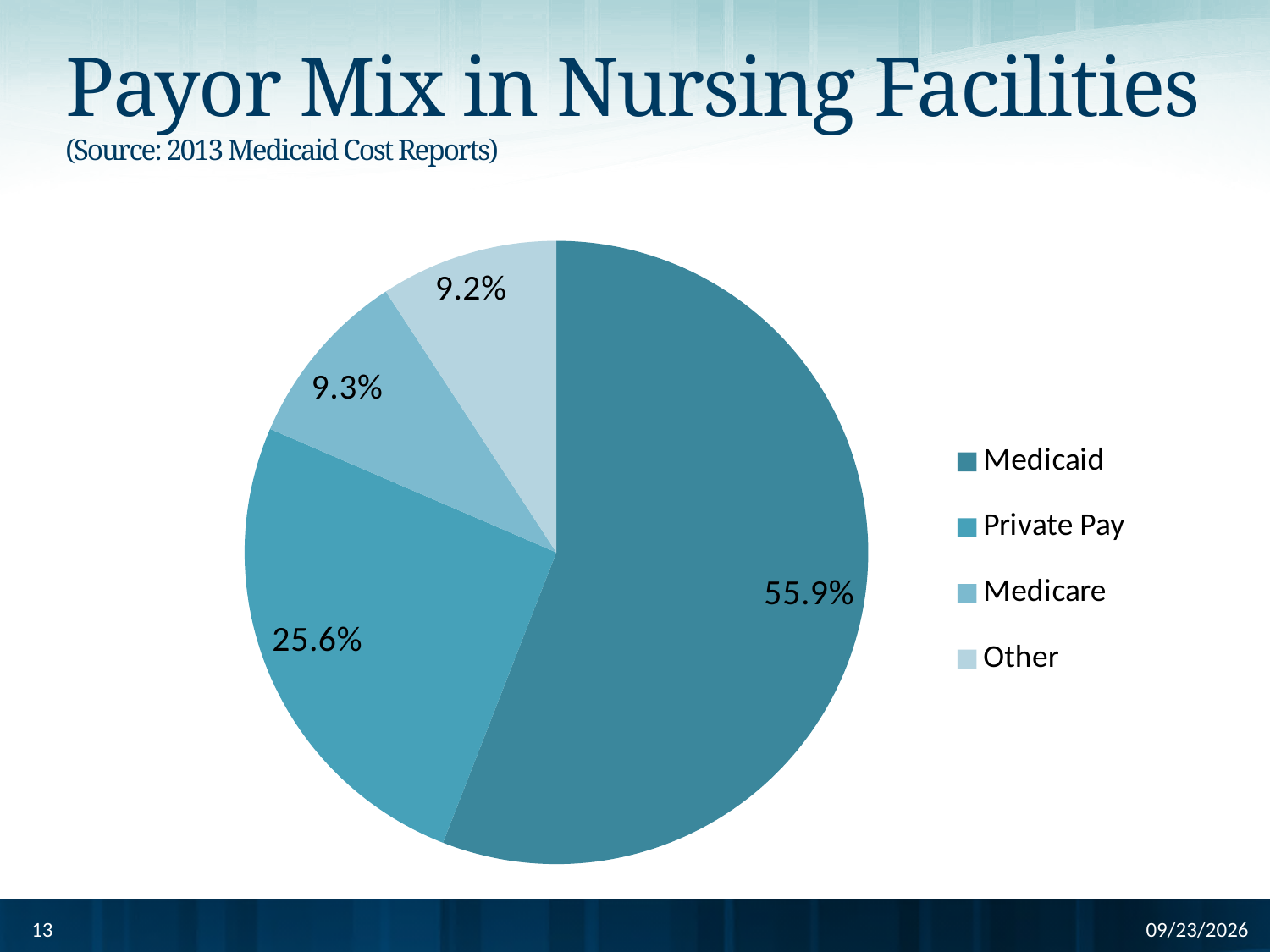
What type of chart is shown on the slide? Pie chart What percentage is shown for Private Pay? 25.6% What percentage is shown for Other? 9.2% What share of the pie does Medicaid represent? 55.9% What source is cited for the chart data? 2013 Medicaid Cost Reports What is the title of the chart on the slide? Payor Mix in Nursing Facilities How many payor categories are shown in the pie chart? 4 Which is larger, the Private Pay share or the Medicare share? Private Pay Which payor has the smallest share of the pie? Other What percentage is shown for Medicare? 9.3% Which payor has the largest share of the pie? Medicaid What is the difference in percentage points between Medicaid and Private Pay? 30.3